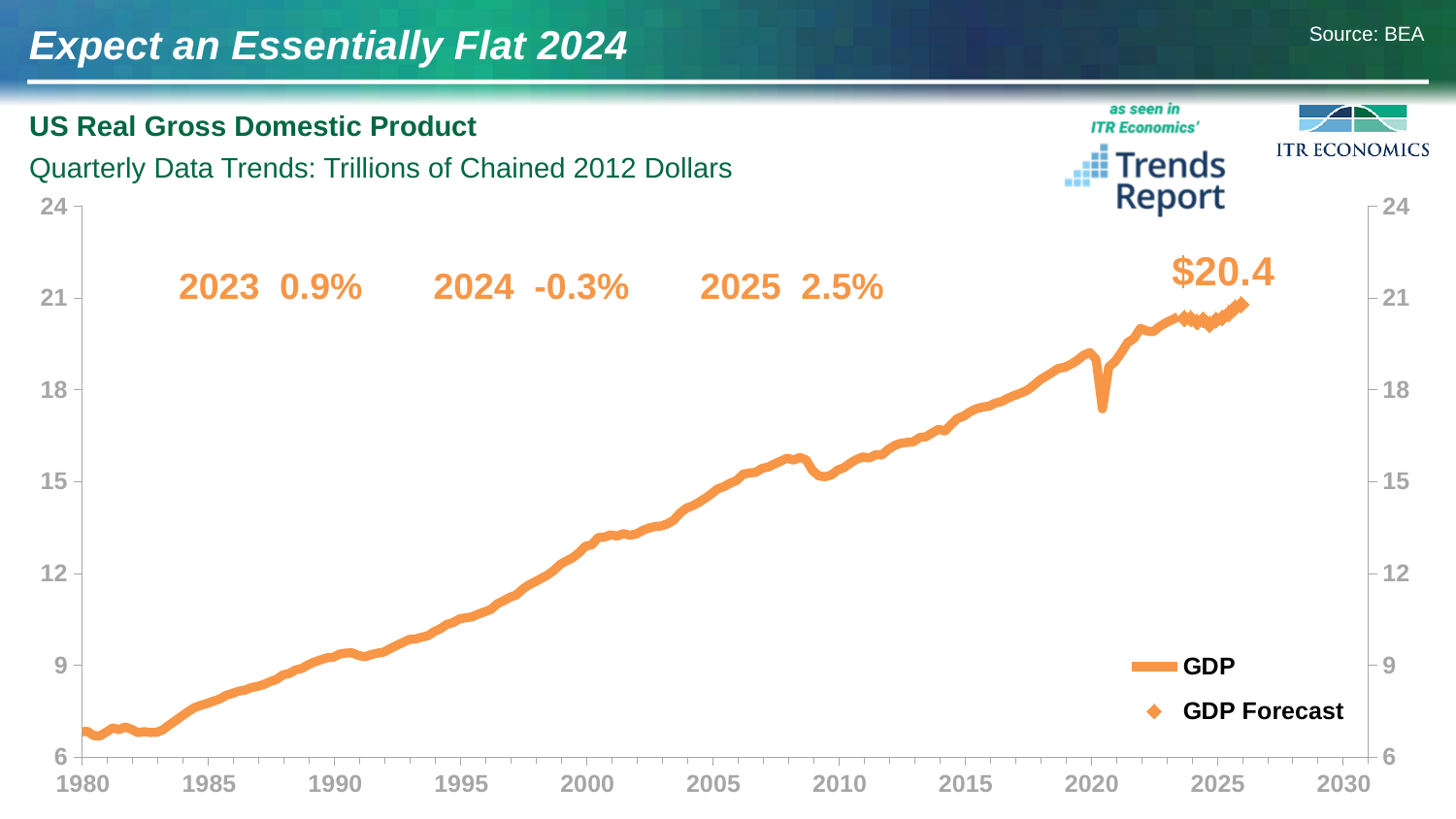
Is the GDP value in 2010 greater or less than 18? less Is the GDP value in 1980 greater or less than 9? less What value is labeled at the end of the GDP forecast line? $20.4 Is the GDP value in 2000 greater or less than 12? greater What is the title of the chart? US Real Gross Domestic Product What kind of chart is shown on the slide? line chart Does the GDP line generally rise or fall from 1980 to 2020? rise How many series does the legend list? 2 What growth rate is annotated for 2025 on the chart? 2.5% Of the three annotated years (2023, 2024, 2025), which has the lowest growth rate? 2024 What growth rate is annotated for 2023 on the chart? 0.9% What growth rate is annotated for 2024 on the chart? -0.3%